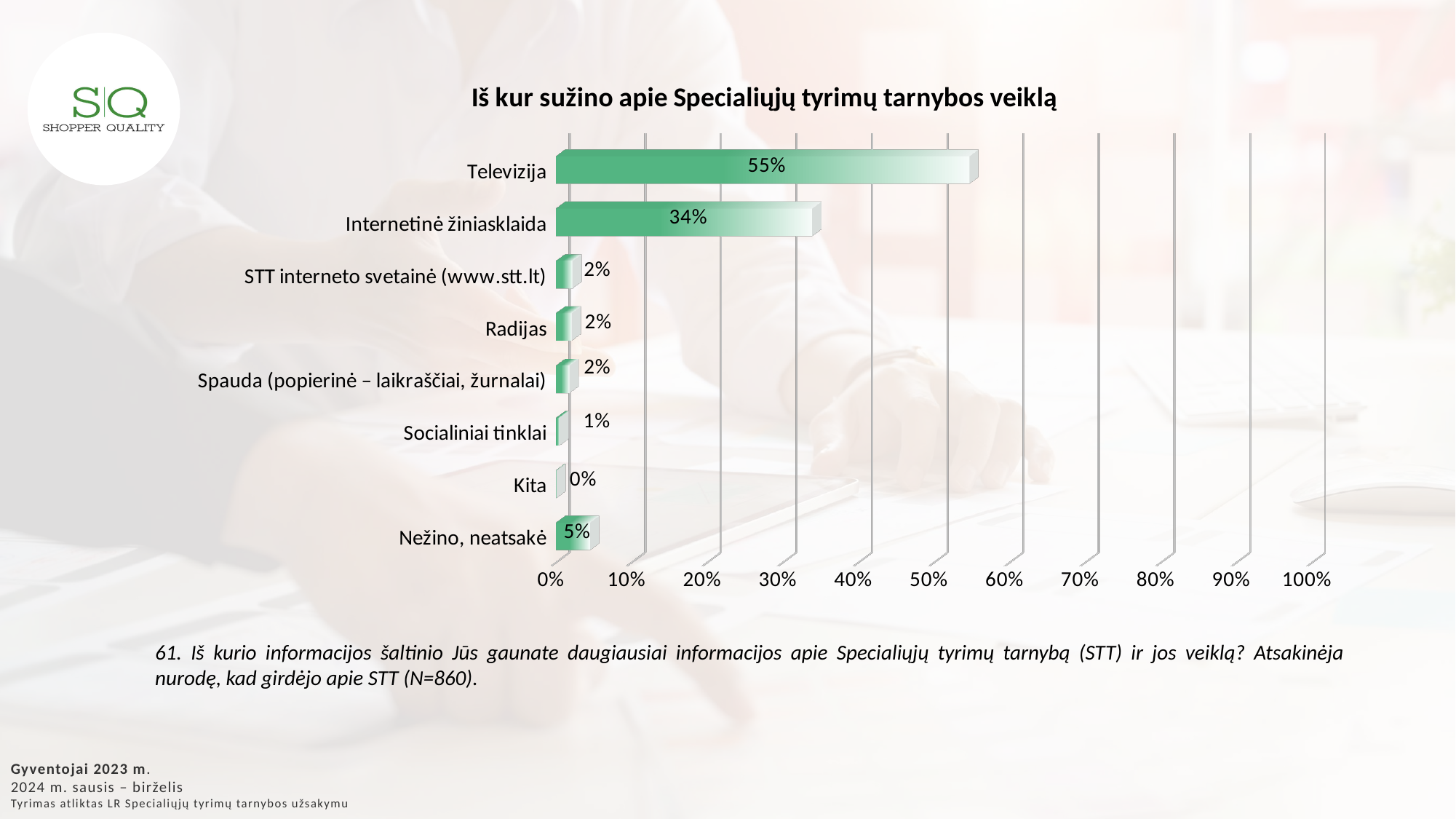
What kind of chart is shown on the slide? bar chart Which category has the lowest value? Kita Is the value for Televizija greater or less than 50%? greater What is the value for Televizija? 55% What is the difference between the values for Televizija and Internetinė žiniasklaida? 21% Which category has the highest value? Televizija What is the value for Socialiniai tinklai? 1% What is the title of the chart? Iš kur sužino apie Specialiųjų tyrimų tarnybos veiklą How many categories are shown in the chart? 8 What is the value for Internetinė žiniasklaida? 34% What is the value for Nežino, neatsakė? 5% Which is larger, the value for Nežino, neatsakė or the value for Radijas? Nežino, neatsakė